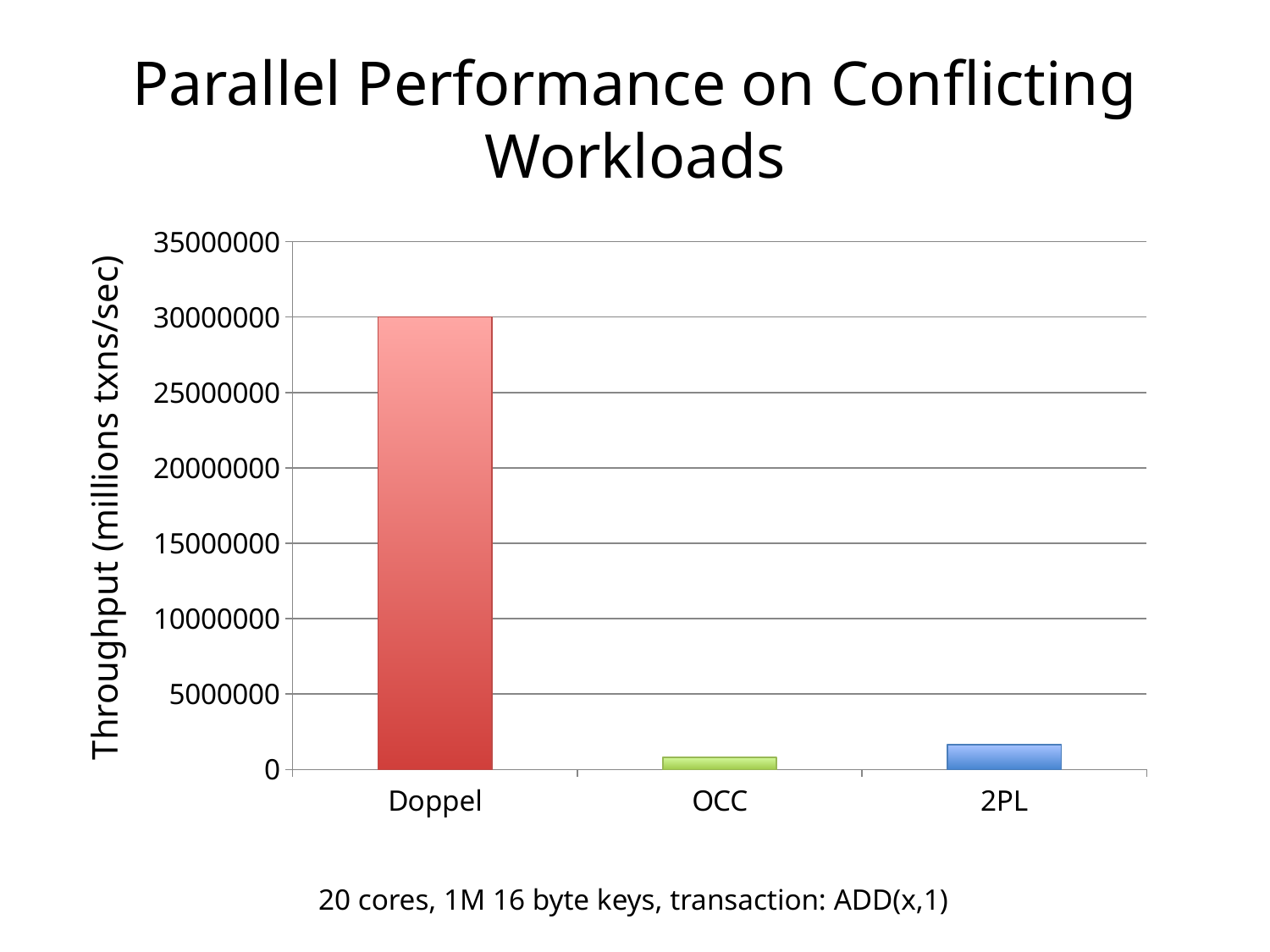
What is the title of the slide containing the chart? Parallel Performance on Conflicting Workloads Which has the larger throughput, OCC or 2PL? 2PL Is the value for Doppel greater or less than 25000000? greater How many categories are plotted on the x axis? 3 Which category has the highest throughput? Doppel Which category has the lowest throughput? OCC Is the value for 2PL greater or less than 5000000? less Is the value for OCC greater or less than 5000000? less What kind of chart is shown on the slide? bar chart Which has the larger throughput, Doppel or 2PL? Doppel What is the label of the y axis? Throughput (millions txns/sec) What is the throughput value for Doppel? 30000000